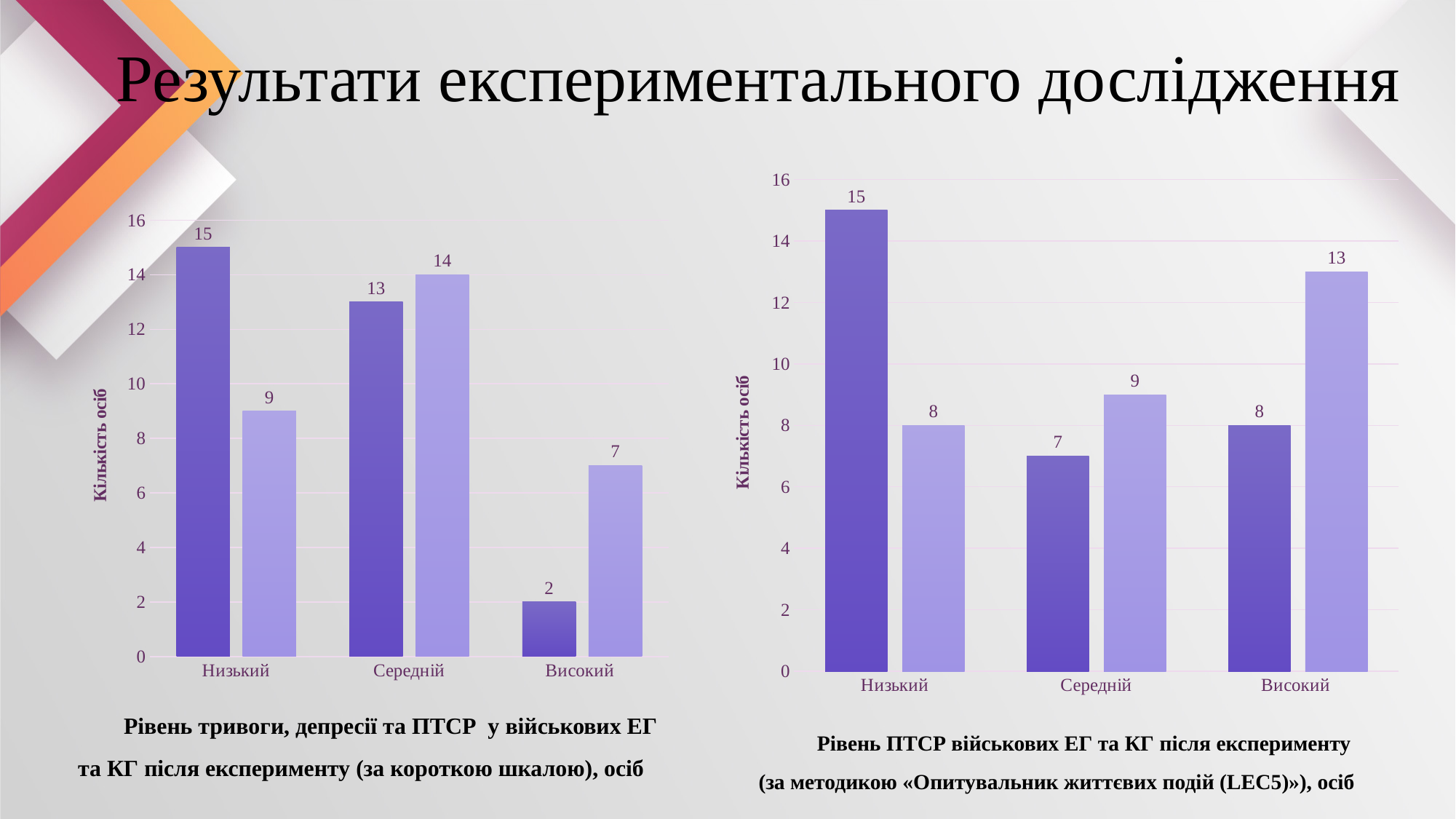
What type of chart is the right chart? bar chart In the left chart, what is the value of the dark purple bar for Високий? 2 In the right chart, what is the difference between the light purple bar and the dark purple bar for Високий? 5 In the left chart, what is the value of the light purple bar for Середній? 14 In the right chart, is the light purple bar for Середній larger or smaller than the dark purple bar for Середній? larger In the left chart, what is the difference between the dark purple bar and the light purple bar for Низький? 6 In the right chart, what is the value of the light purple bar for Високий? 13 In the left chart, which category has the lowest dark purple bar? Високий In the left chart, how many categories are shown on the x axis? 3 In the right chart, what is the value of the dark purple bar for Середній? 7 In the right chart, which category has the highest dark purple bar? Низький In the left chart, what is the value of the dark purple bar for Низький? 15